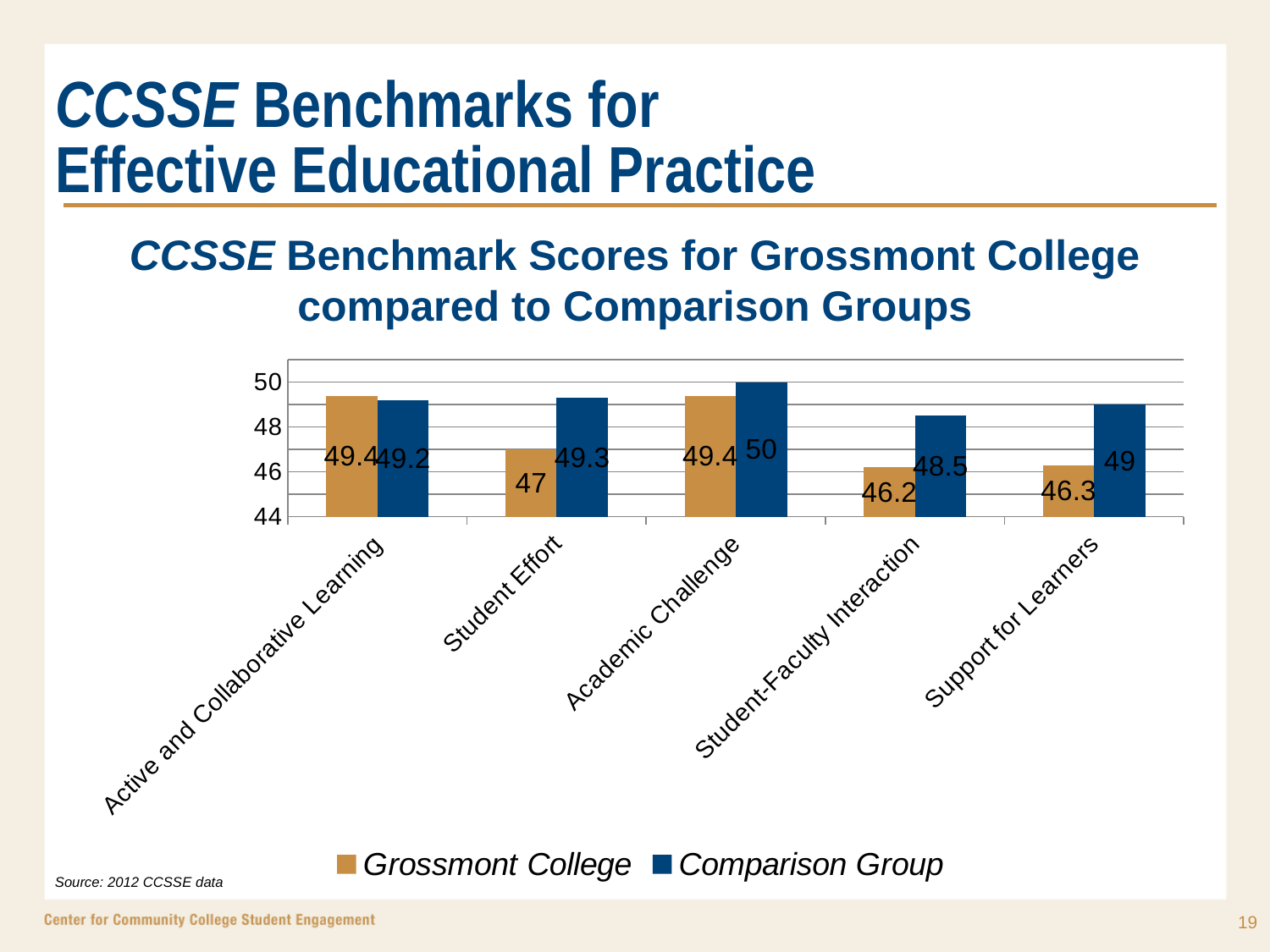
Which benchmark has the lowest Grossmont College score? Student-Faculty Interaction How many benchmark categories are shown on the x axis? 5 Which benchmark has the highest Comparison Group score? Academic Challenge Is the Grossmont College score for Support for Learners greater or less than 48? less What is the Comparison Group score for Support for Learners? 49 What kind of chart is shown on the slide? Bar chart What is the Grossmont College score for Student Effort? 47 How many series does the legend list? 2 For Active and Collaborative Learning, which is higher: Grossmont College or the Comparison Group? Grossmont College What is the Grossmont College score for Student-Faculty Interaction? 46.2 What is the difference between the Comparison Group and Grossmont College scores for Student-Faculty Interaction? 2.3 What is the Comparison Group score for Academic Challenge? 50